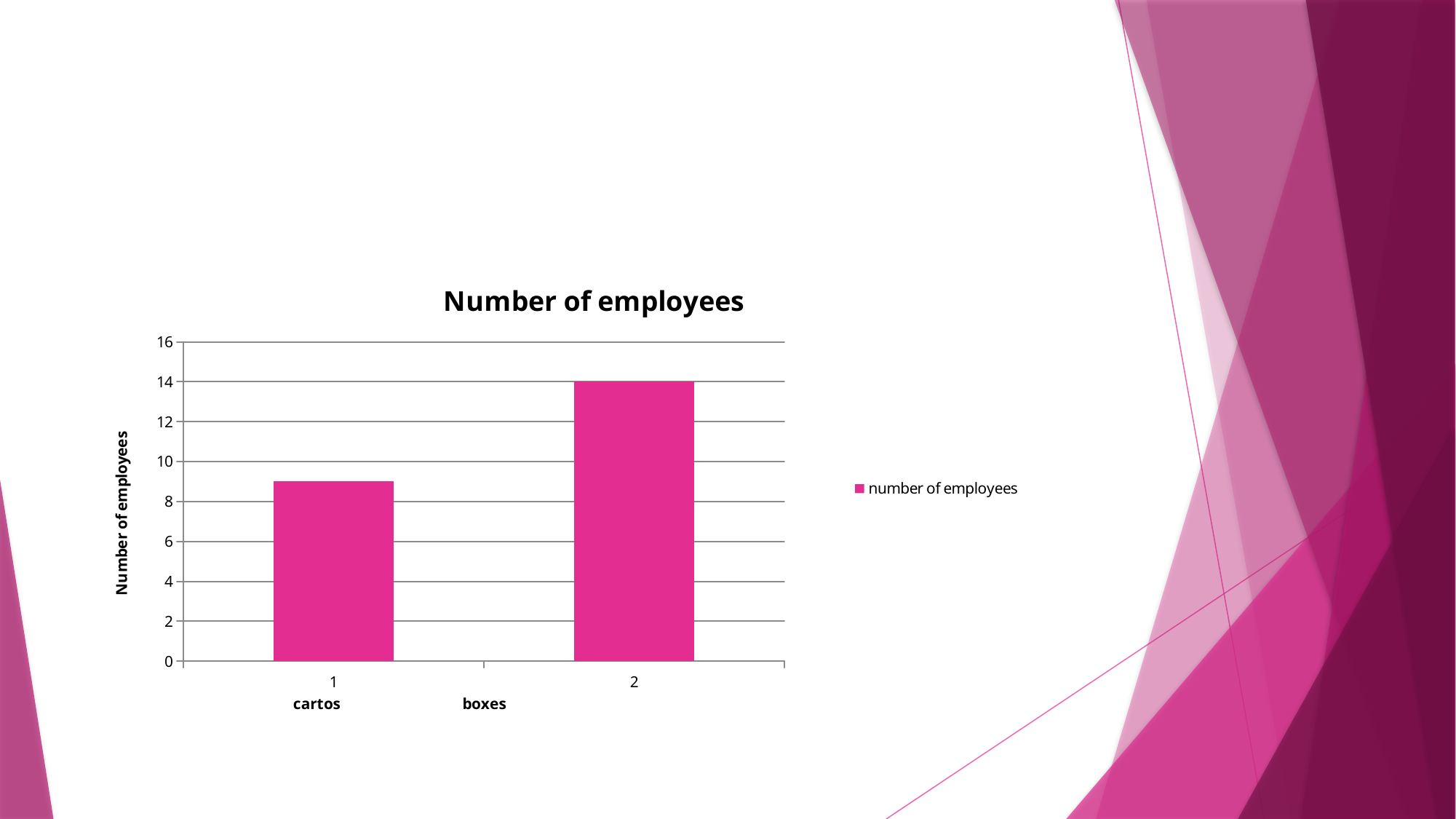
What kind of chart is shown on the slide? bar chart Is the value for category 1 greater or less than 8? greater Which category has the highest number of employees? 2 What is the title of the chart? Number of employees Do the values rise or fall from category 1 to category 2? rise What is the value of the bar for category 2? 14 Which category has the lowest number of employees? 1 How many bars are plotted in the chart? 2 What is the legend entry for the series? number of employees Is the value for category 1 greater or less than 10? less How many series does the legend list? 1 Which bar is taller, category 1 or category 2? 2